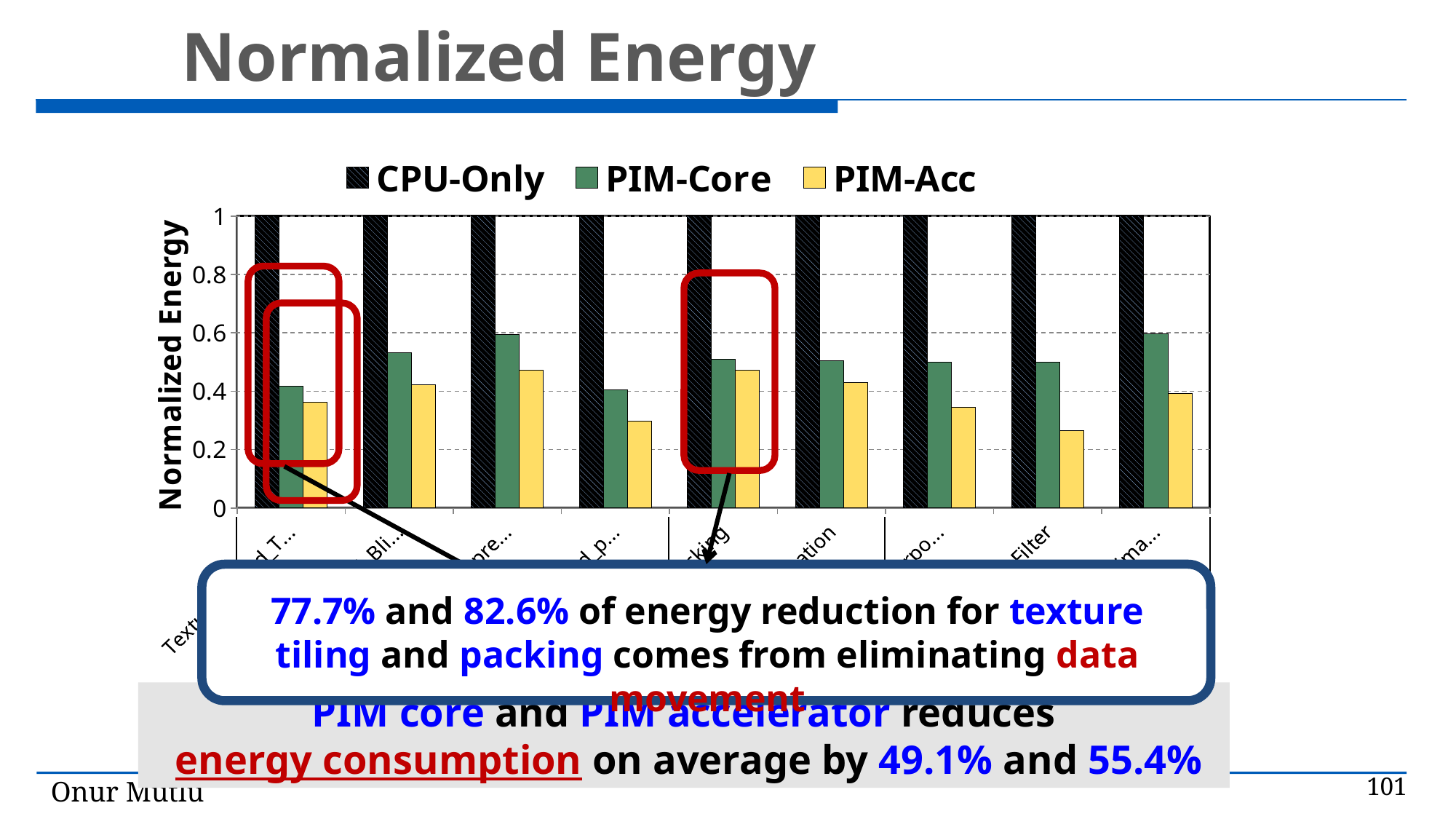
How many category groups are plotted along the x axis? 9 What is the CPU-Only value for the Filter category? 1 Is the PIM-Acc value for Filter greater or less than 0.2? greater Which series are listed in the legend? CPU-Only, PIM-Core, PIM-Acc For the Filter category, which is larger: PIM-Core or PIM-Acc? PIM-Core Is the PIM-Acc value for Filter greater or less than 0.4? less Which series has the highest value in every category? CPU-Only What is the label of the y axis? Normalized Energy For the Filter category, which series has the lowest value? PIM-Acc Is the PIM-Core value for Filter greater or less than 0.4? greater What kind of chart is shown on the slide? bar chart How many series does the legend list? 3